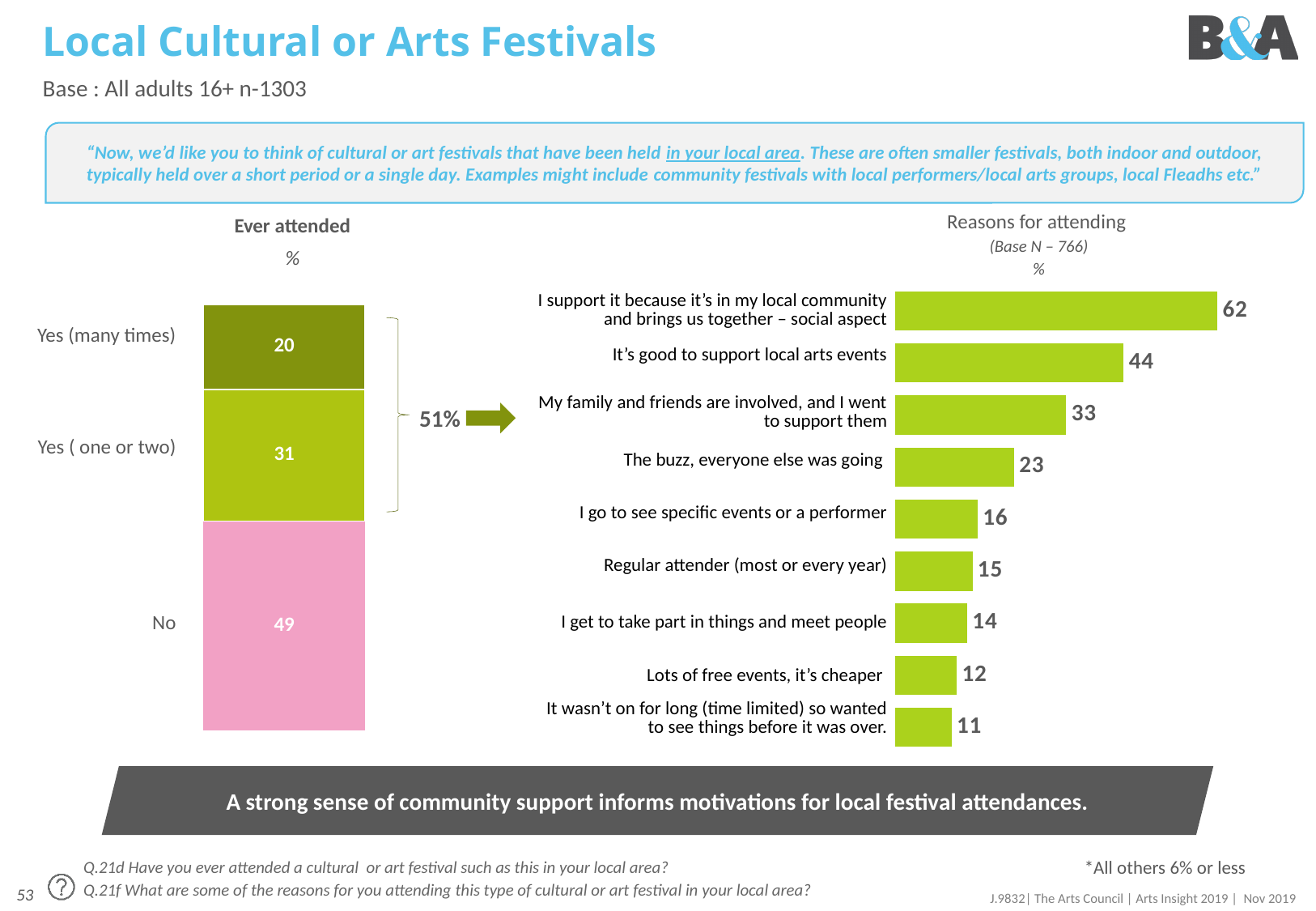
In the 'Ever attended' chart, what is the value for 'Yes (many times)'? 20 In the 'Reasons for attending' chart, what is the difference between the top reason (62) and 'My family and friends are involved, and I went to support them' (33)? 29 What type of chart is the 'Reasons for attending' chart? Bar chart How many reasons are listed in the 'Reasons for attending' chart? 9 In the 'Ever attended' chart, what percentage answered 'No'? 49 In the 'Reasons for attending' chart, which reason has the highest value? I support it because it's in my local community and brings us together – social aspect In the 'Reasons for attending' chart, what is the value for 'The buzz, everyone else was going'? 23 In the 'Reasons for attending' chart, what is the value for 'It's good to support local arts events'? 44 In the 'Ever attended' chart, what is the combined share for the two 'Yes' categories shown by the bracket? 51% In the 'Reasons for attending' chart, which is larger: 'Regular attender (most or every year)' or 'I get to take part in things and meet people'? Regular attender (most or every year) In the 'Ever attended' chart, what is the difference between 'Yes (one or two)' and 'Yes (many times)'? 11 In the 'Reasons for attending' chart, which reason has the lowest value? It wasn't on for long (time limited) so wanted to see things before it was over.